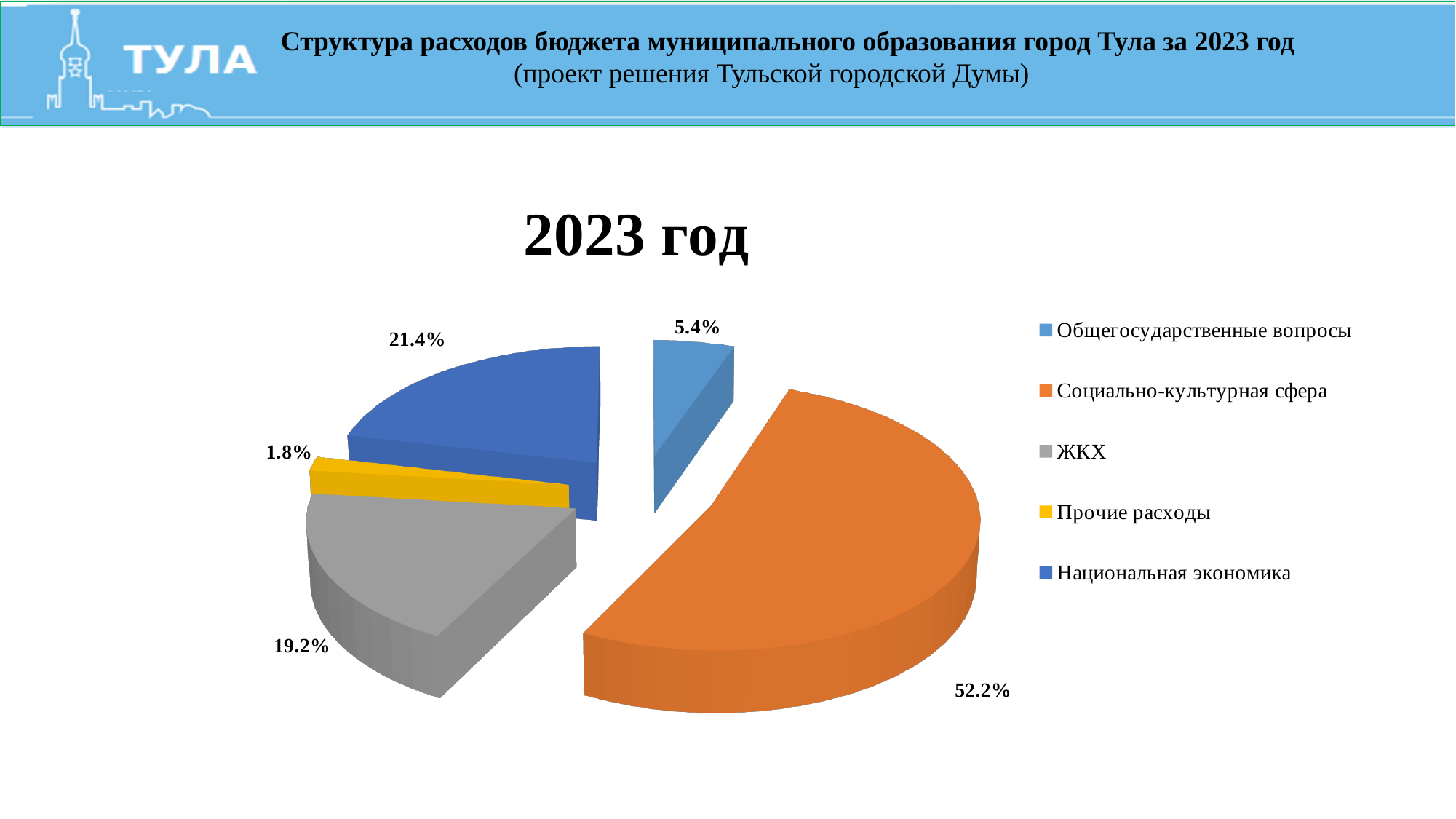
What is the value for Прочие расходы? 1.8% Which is larger, Общегосударственные вопросы or Прочие расходы? Общегосударственные вопросы What is the chart's title? 2023 год What is the value for Общегосударственные вопросы? 5.4% Which category has the smallest share? Прочие расходы How many categories does the legend list? 5 Which category has the largest share? Социально-культурная сфера What is the value for Национальная экономика? 21.4% What is the value for ЖКХ? 19.2% What is the difference between Национальная экономика and ЖКХ? 2.2% What share of the pie is Социально-культурная сфера? 52.2% What type of chart is shown on the slide? pie chart